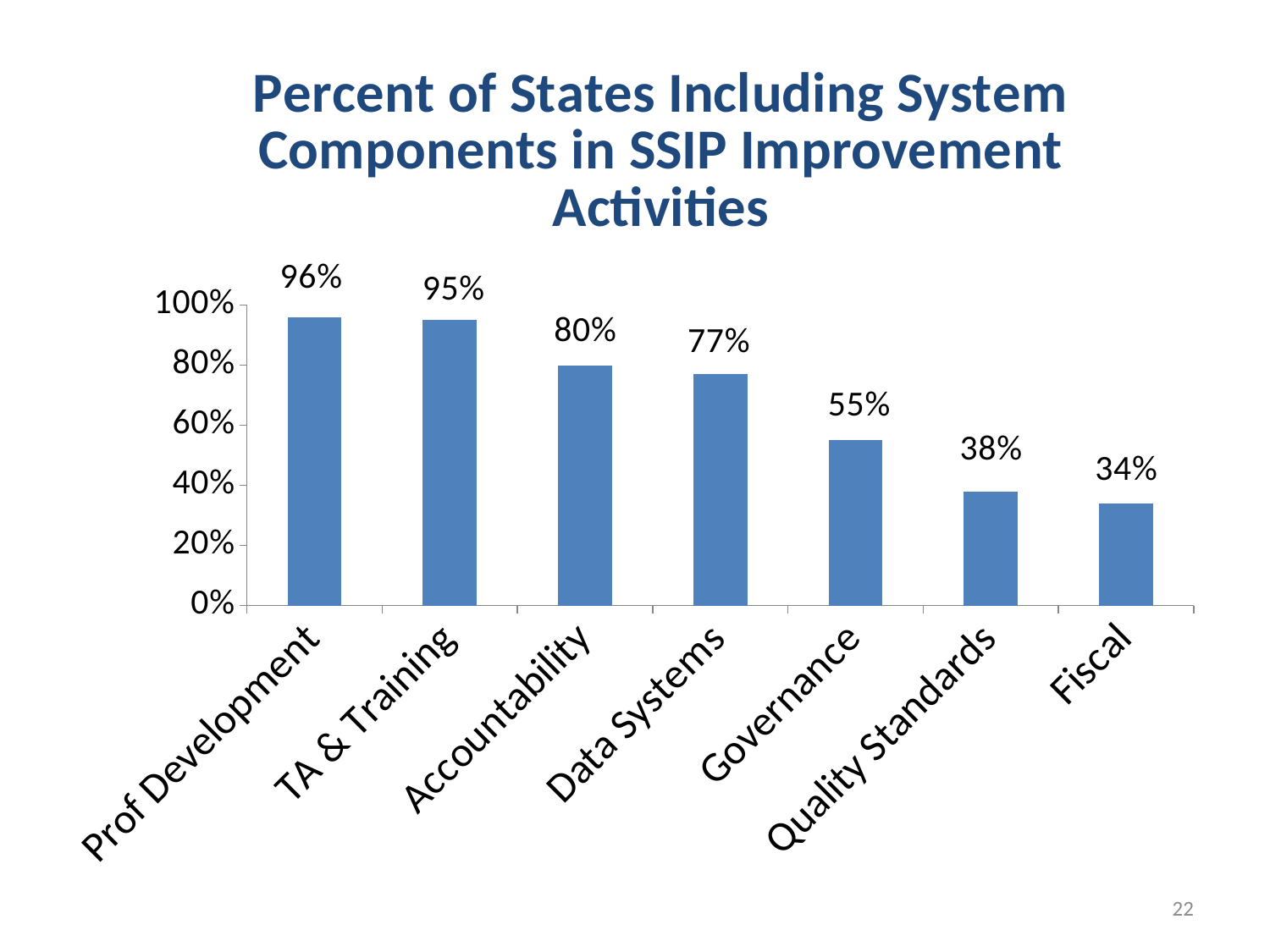
What percent of states included Prof Development in SSIP improvement activities? 96% Is the value for Data Systems greater or less than 60%? greater How many system components are shown on the chart? 7 What is the value shown for Quality Standards? 38% What is the difference between the values for TA & Training and Fiscal? 61% What is the difference between the values for Accountability and Data Systems? 3% Which is larger, the value for Governance or the value for Quality Standards? Governance What is the value shown for Governance? 55% Do the values rise or fall from left to right across the categories? Fall What kind of chart is shown on the slide? Bar chart Which system component has the lowest percent of states? Fiscal Which system component has the highest percent of states? Prof Development